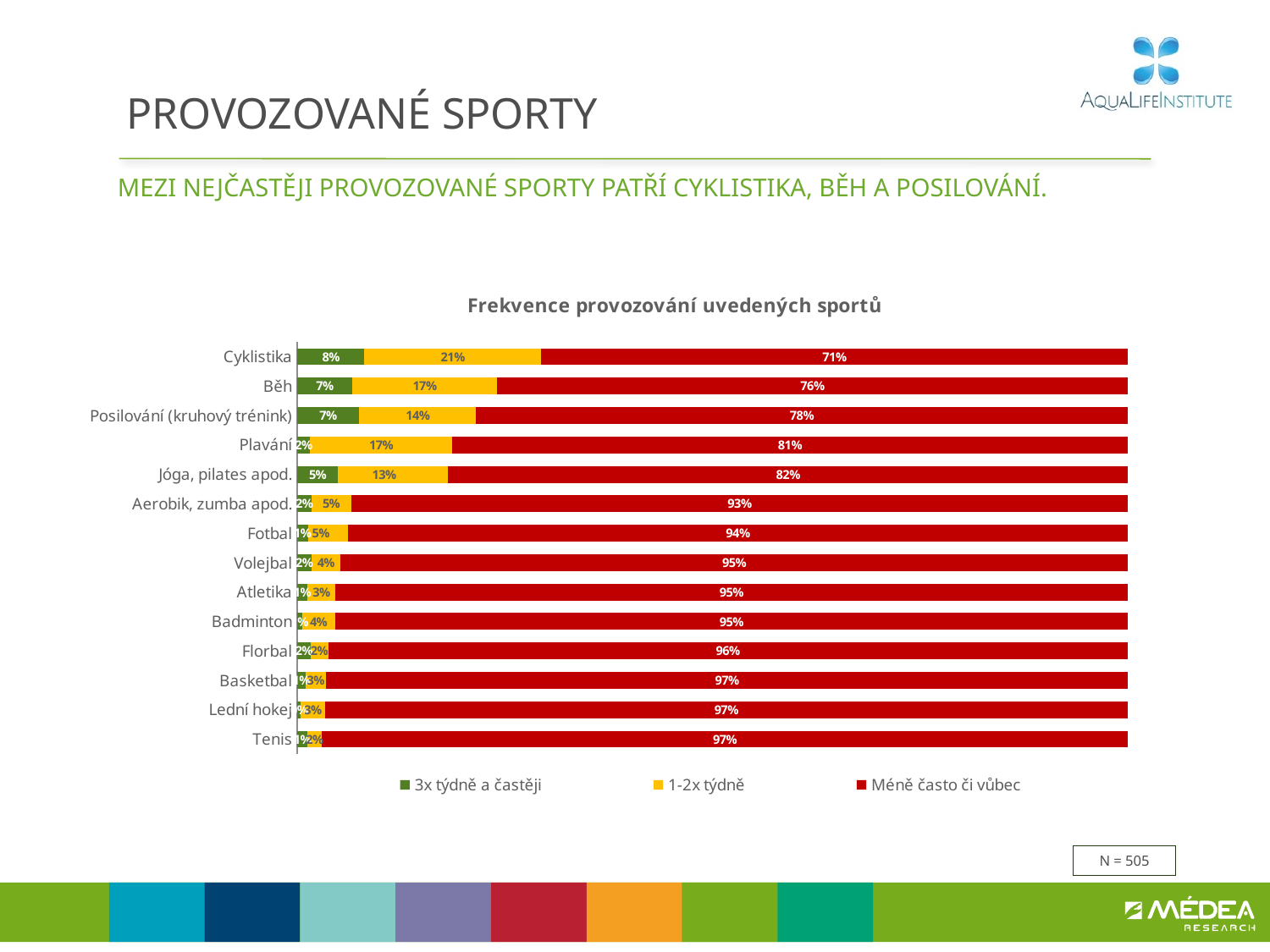
What type of chart is shown on the slide? Stacked bar chart What is the Méně často či vůbec value for Jóga, pilates apod.? 82% Which sport has the lowest Méně často či vůbec value? Cyklistika How many series does the legend list? 3 Which is larger: the 1-2x týdně value for Plavání or for Jóga, pilates apod.? Plavání What is the Méně často či vůbec value for Tenis? 97% Which sport has the highest value in the 1-2x týdně series? Cyklistika How many sports (categories) are shown in the chart? 14 What is the value for Běh in the 1-2x týdně series? 17% What is the title of the chart? Frekvence provozování uvedených sportů What percentage of respondents do Cyklistika 3x týdně a častěji? 8% What is the difference between the Méně často či vůbec values for Posilování (kruhový trénink) and Cyklistika? 7%